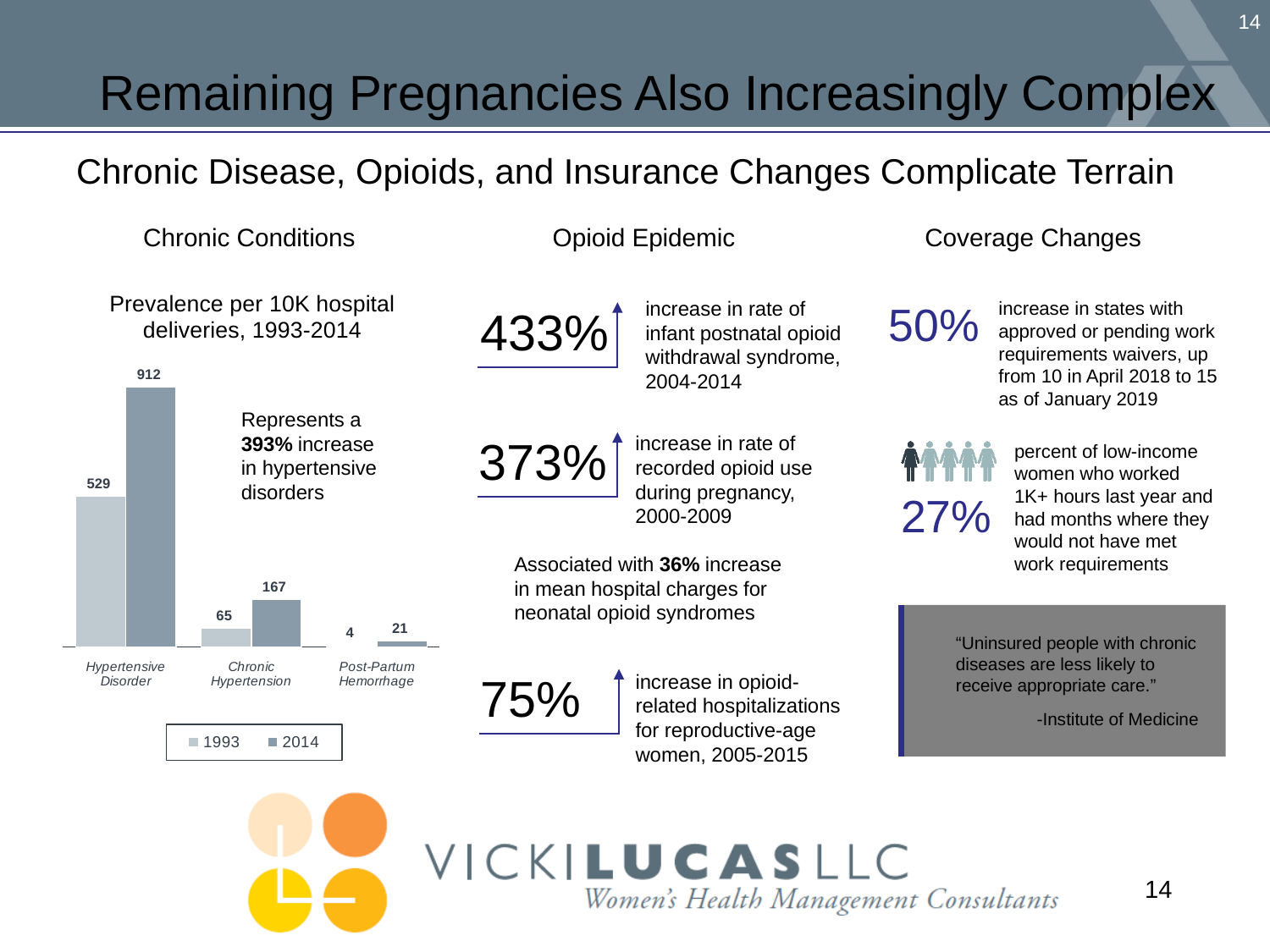
Which category has the highest 2014 value in the chart? Hypertensive Disorder What is the 2014 value for Hypertensive Disorder in the chart? 912 What is the 1993 value for Hypertensive Disorder in the chart? 529 What is the difference between the 2014 and 1993 values for Chronic Hypertension? 102 Which is larger: the 2014 value for Chronic Hypertension or the 1993 value for Hypertensive Disorder? 1993 value for Hypertensive Disorder What is the difference between the 2014 and 1993 values for Hypertensive Disorder? 383 How many categories are shown on the x axis of the chart? 3 What is the 2014 value for Post-Partum Hemorrhage in the chart? 21 What type of chart is shown on the slide? Bar chart How many series does the chart legend list? 2 Which category has the lowest 1993 value in the chart? Post-Partum Hemorrhage What is the 1993 value for Chronic Hypertension in the chart? 65